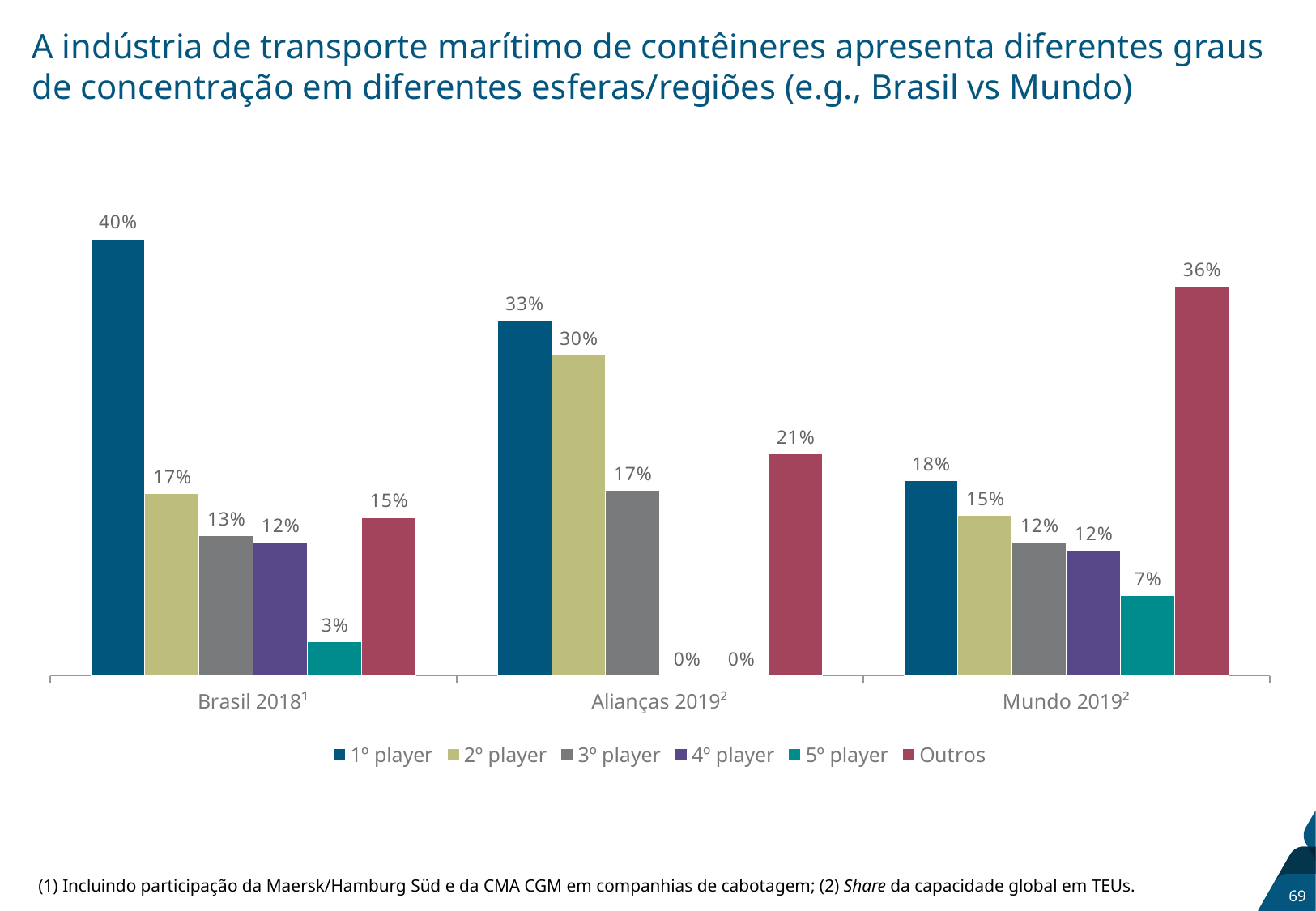
What is the difference between the 1º player value in Brasil 2018 and the 1º player value in Mundo 2019? 22% What is the value for the 2º player in Alianças 2019? 30% Which is larger: the 3º player value in Alianças 2019 or the 3º player value in Mundo 2019? Alianças 2019 What is the value for the 4º player in Alianças 2019? 0% Which series has the lowest value in the Brasil 2018 group? 5º player Which series has the highest value in the Mundo 2019 group? Outros What kind of chart is shown on the slide? Bar chart What is the value for Outros in Mundo 2019? 36% How many category groups are shown on the x axis? 3 What is the value for the 5º player in Mundo 2019? 7% What is the value for the 1º player in Brasil 2018? 40% How many series does the legend list? 6